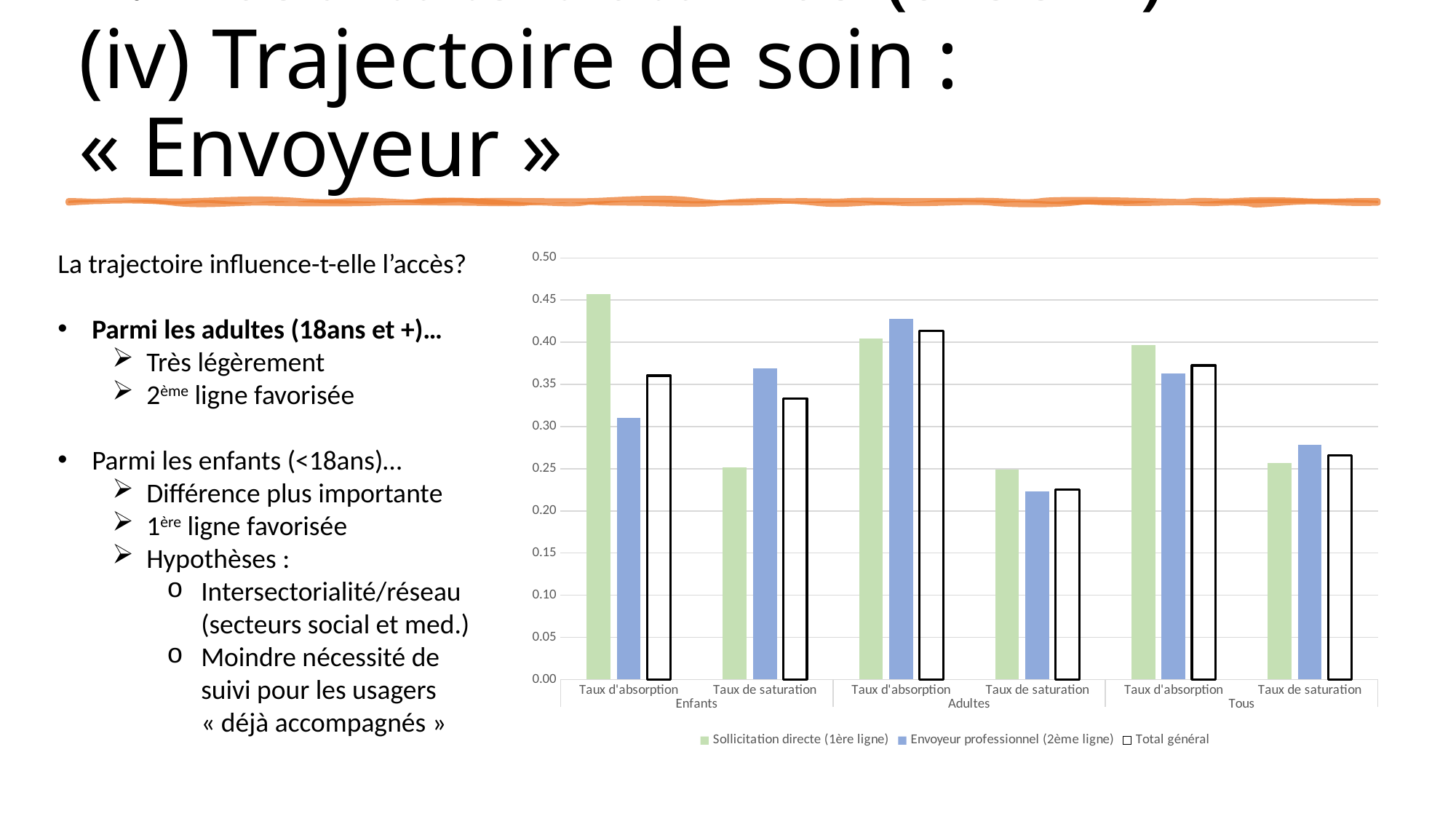
What colour represents the Sollicitation directe (1ère ligne) series in the chart? green Is the value of Total général for Taux d'absorption among Tous greater or less than 0.35? greater For Taux d'absorption among Enfants, which is larger: Sollicitation directe (1ère ligne) or Envoyeur professionnel (2ème ligne)? Sollicitation directe (1ère ligne) Is the value of Envoyeur professionnel (2ème ligne) for Taux de saturation among Adultes greater or less than 0.25? less For Taux de saturation among Enfants, which is larger: Sollicitation directe (1ère ligne) or Envoyeur professionnel (2ème ligne)? Envoyeur professionnel (2ème ligne) What are the three population groups labelled along the x axis of the chart? Enfants, Adultes, Tous In which category does the Envoyeur professionnel (2ème ligne) series have its lowest value? Taux de saturation, Adultes Is the value of Sollicitation directe (1ère ligne) for Taux d'absorption among Enfants greater or less than 0.40? greater How many groups of bars (categories) are plotted along the x axis of the chart? 6 What kind of chart is shown on the slide? bar chart How many series does the chart legend list? 3 In which category does the Sollicitation directe (1ère ligne) series reach its highest value? Taux d'absorption, Enfants